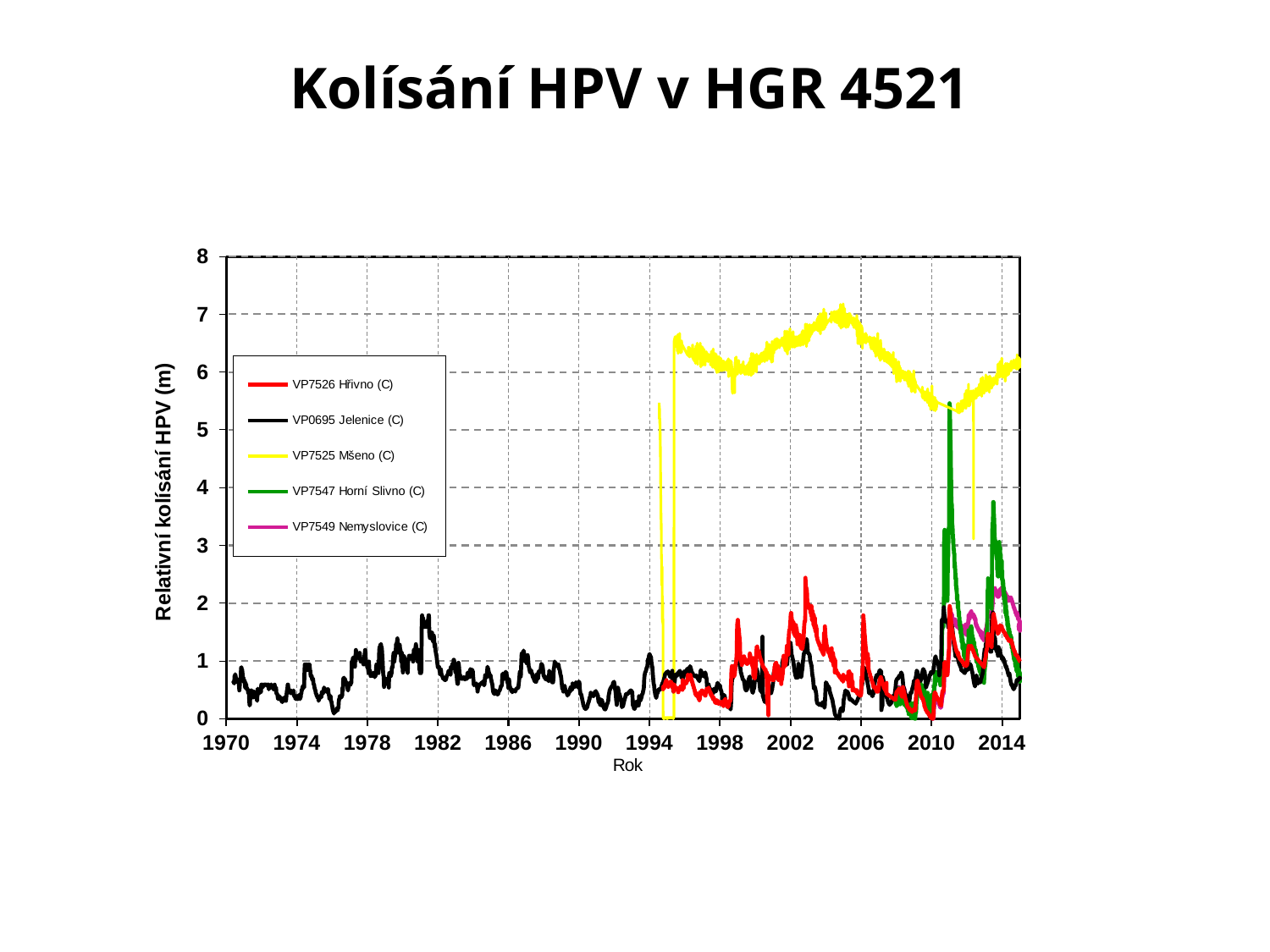
Is the value for VP7549 Nemyslovice (C) around 2013 greater or less than 3? less What kind of chart is shown on the slide? line chart Which series is plotted highest on the chart for the period from 1996 to 2014? VP7525 Mšeno (C) Around 2011, which series reaches a higher peak: VP7547 Horní Slivno (C) or VP7526 Hřivno (C)? VP7547 Horní Slivno (C) Which colour is used for the VP7547 Horní Slivno (C) series? green How many series does the legend list? 5 Does the VP7525 Mšeno (C) series rise or fall between 2005 and 2010? fall Is the value for VP7525 Mšeno (C) around 2004 greater or less than 6? greater Which series has data starting at 1970? VP0695 Jelenice (C) What is the title of the chart? Kolísání HPV v HGR 4521 Is the value for VP0695 Jelenice (C) around 1976 greater or less than 2? less